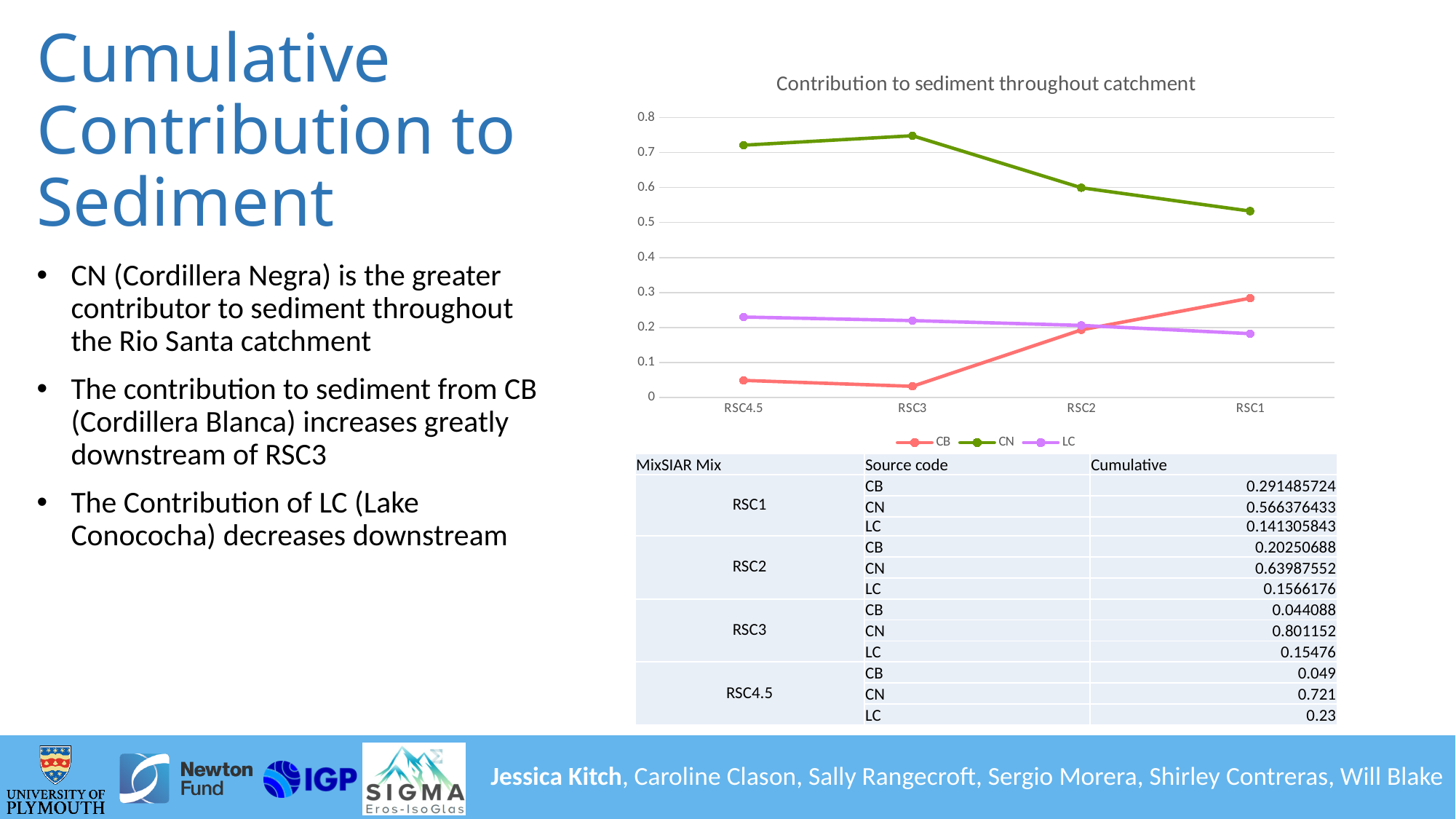
Which series has the lowest value at RSC4.5? CB Is the value for CB at RSC3 greater or less than 0.1? less According to the table below the chart, what is the cumulative value for CN at RSC4.5? 0.721 What is the title of the chart? Contribution to sediment throughout catchment At RSC1, which series has the larger value, CB or LC? CB Is the value for CN at RSC4.5 greater or less than 0.6? greater Which series has the highest value at RSC3? CN How many series does the legend of the chart list? 3 How many categories are shown along the x axis of the chart? 4 What kind of chart is shown on the slide? line chart Does the CB line rise or fall from RSC3 to RSC1? rise Does the CN line rise or fall from RSC3 to RSC1? fall